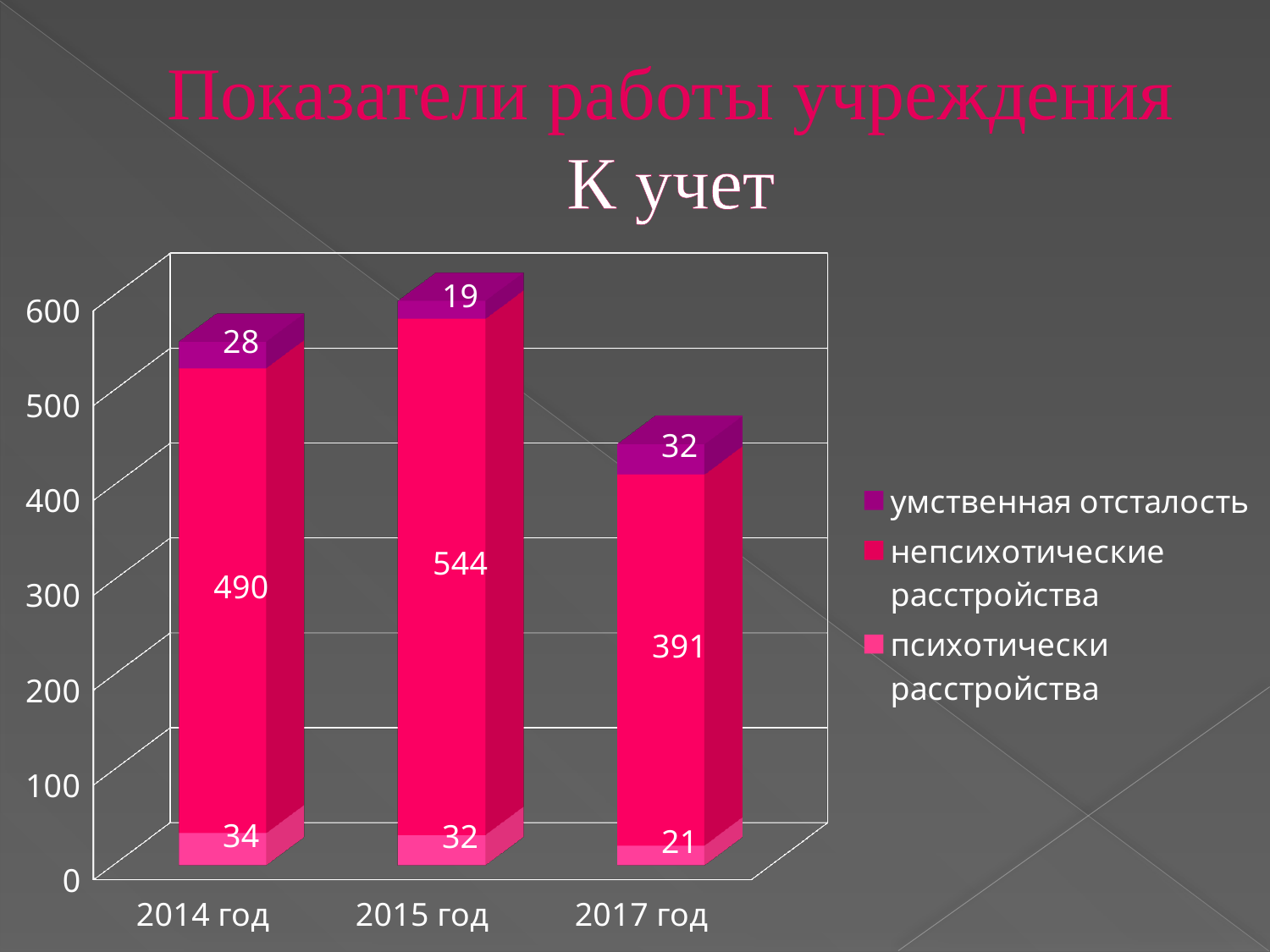
What is the total of the stacked bar for 2014 год? 552 What is the value for непсихотические расстройства in 2015 год? 544 How many years are shown on the x axis? 3 What is the value for умственная отсталость in 2017 год? 32 How many series does the legend list? 3 What is the value for психотически расстройства in 2014 год? 34 What is the difference between the непсихотические расстройства values for 2015 год and 2017 год? 153 Which year has the lowest value for психотически расстройства? 2017 год What is the total of the stacked bar for 2017 год? 444 Which year has the highest value for непсихотические расстройства? 2015 год What kind of chart is shown on the slide? Stacked bar chart Which is larger: умственная отсталость in 2014 год or in 2015 год? 2014 год